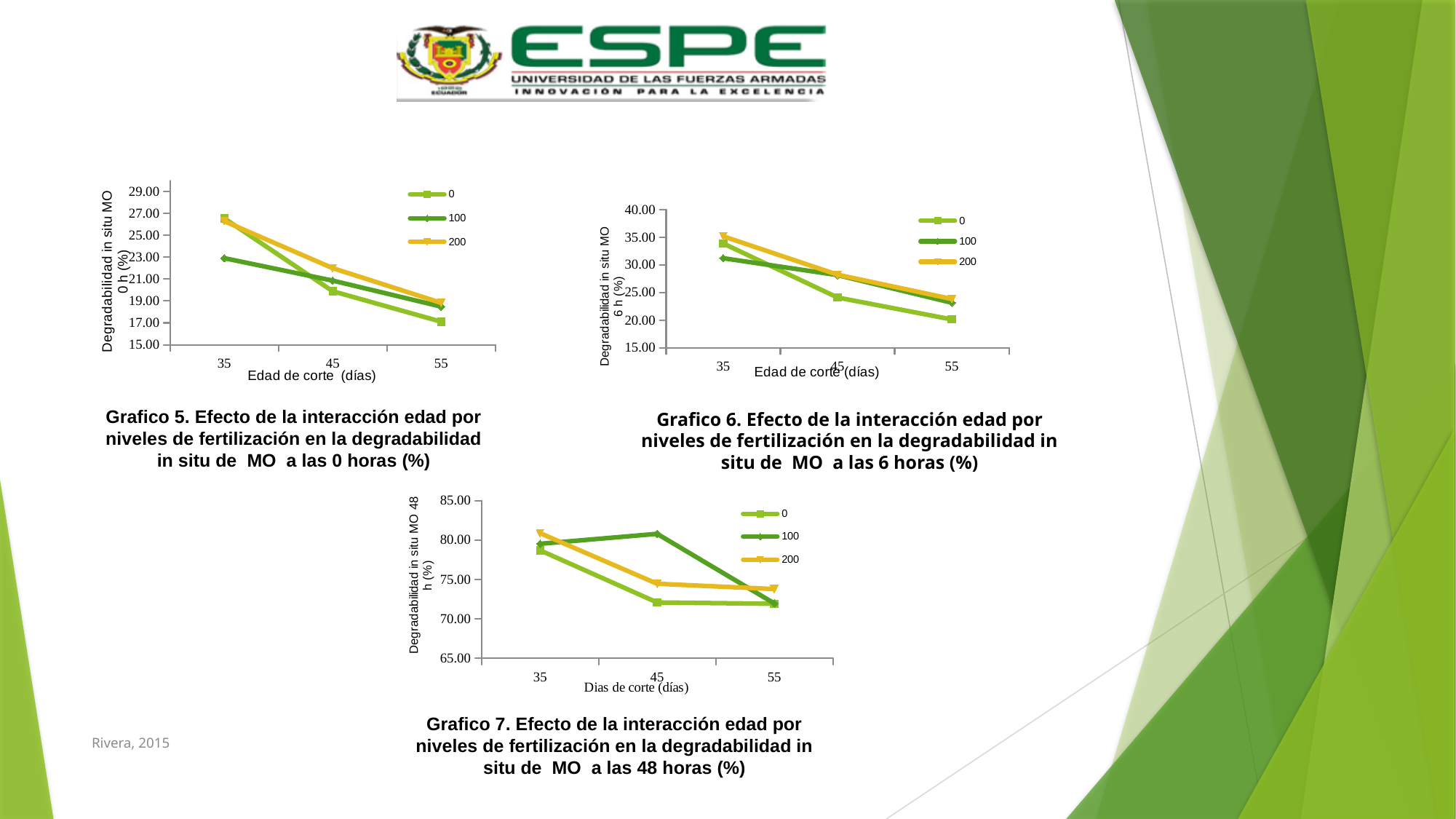
In Grafico 6, how many series does the legend list? 3 In Grafico 6, at 55 days, which series has the larger value: 0 or 200? 200 In Grafico 5, which series has the lowest value at 55 days? 0 In Grafico 6, does the value for series 200 rise or fall from 35 to 55 days? fall In Grafico 6, is the value for series 0 at 35 days greater or less than 30.00? greater In Grafico 7, how many cutting ages are shown on the x axis? 3 What kind of chart is Grafico 5? line chart In Grafico 7, at 45 days, which series has the larger value: 0 or 100? 100 In Grafico 7, is the value for series 100 at 45 days greater or less than 80.00? greater In Grafico 5, is the value for series 100 at 35 days greater or less than 25.00? less In Grafico 5, does the value for series 0 rise or fall as the cutting age increases from 35 to 55 days? fall What is the x-axis label of Grafico 7? Dias de corte (días)